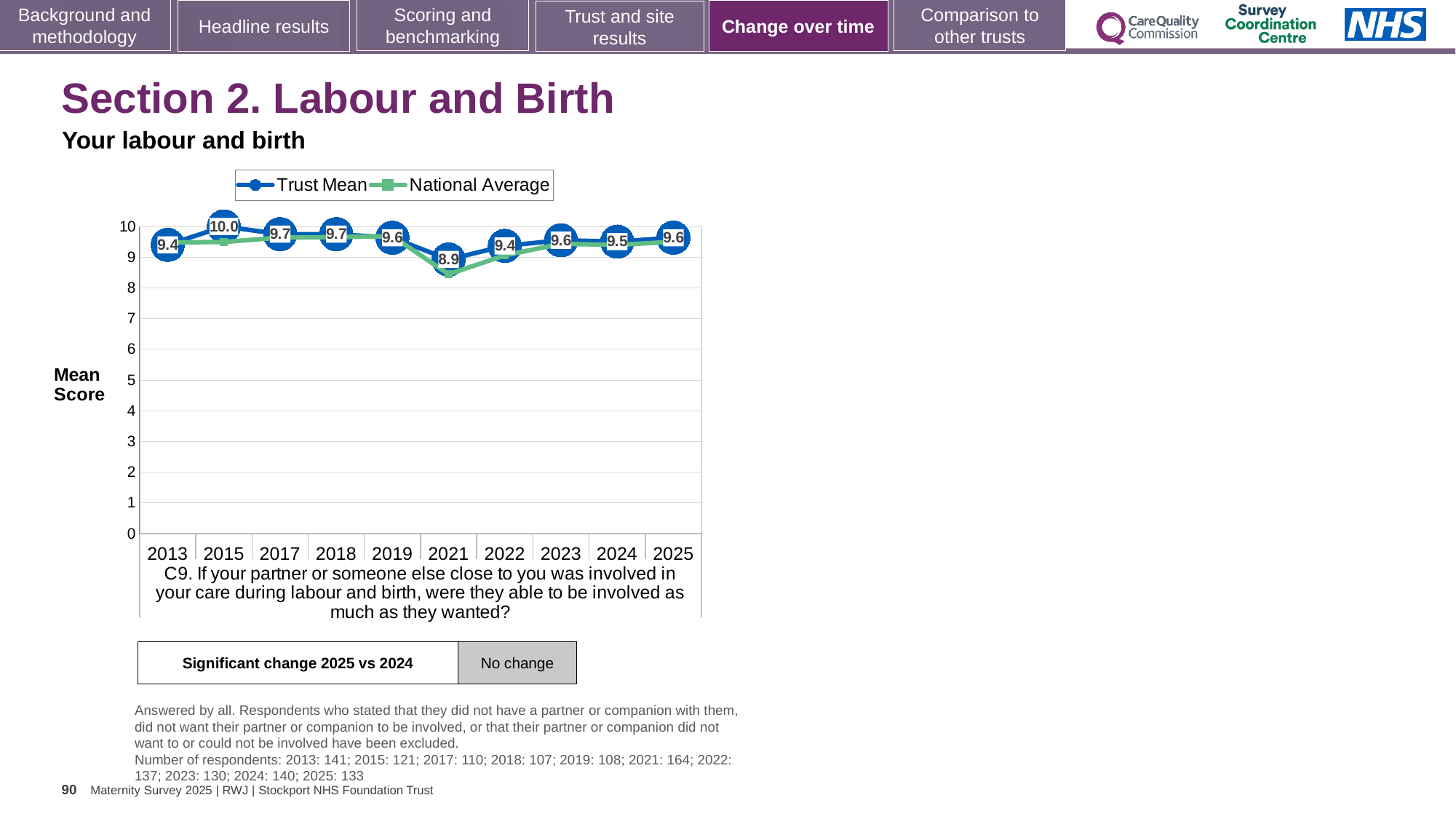
What is the Trust Mean value for 2015? 10.0 How many years are shown on the x axis? 10 Which year has the larger Trust Mean, 2013 or 2019? 2019 Is the National Average value for 2021 greater or less than 9? less How many series does the legend list? 2 What is the Trust Mean value for 2021? 8.9 Does the Trust Mean rise or fall from 2021 to 2023? Rise What is the difference between the Trust Mean in 2015 and in 2021? 1.1 What kind of chart is shown? Line chart What is the Trust Mean value for 2025? 9.6 In which year is the Trust Mean highest? 2015 In which year is the Trust Mean lowest? 2021